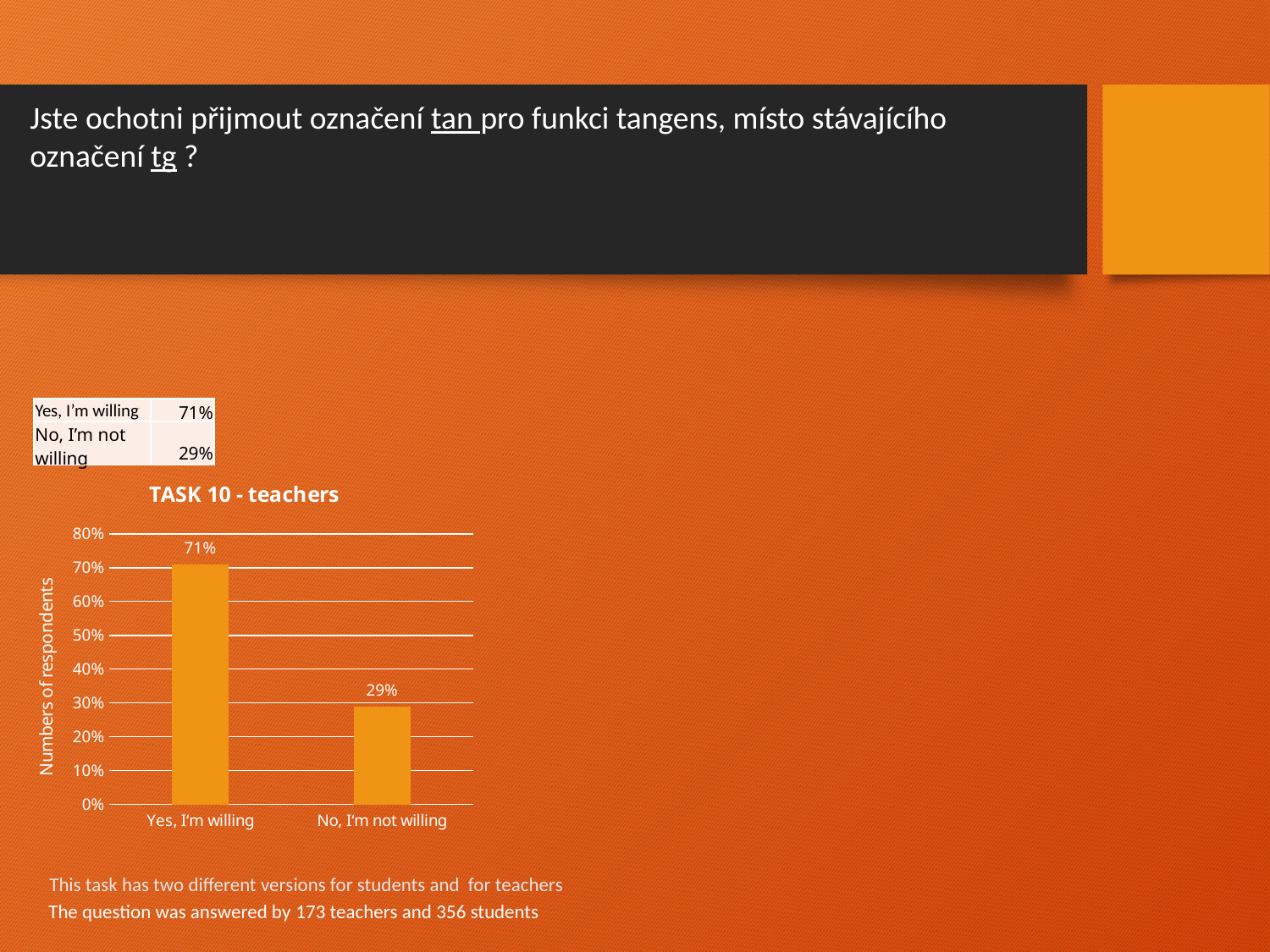
What is the label of the vertical axis in the TASK 10 - teachers chart? Numbers of respondents Which is larger in the TASK 10 - teachers chart: "Yes, I'm willing" or "No, I'm not willing"? Yes, I'm willing Which category has the lowest value in the TASK 10 - teachers chart? No, I'm not willing What is the title of the chart on the slide? TASK 10 - teachers Is the value for "Yes, I'm willing" greater or less than 60% in the TASK 10 - teachers chart? greater Is the value for "No, I'm not willing" greater or less than 40% in the TASK 10 - teachers chart? less What is the value for "Yes, I'm willing" in the TASK 10 - teachers chart? 71% What is the value for "No, I'm not willing" in the TASK 10 - teachers chart? 29% What is the difference between the values for "Yes, I'm willing" and "No, I'm not willing" in the TASK 10 - teachers chart? 42% What kind of chart is the TASK 10 - teachers chart? bar chart How many categories are shown in the TASK 10 - teachers chart? 2 Which category has the highest value in the TASK 10 - teachers chart? Yes, I'm willing